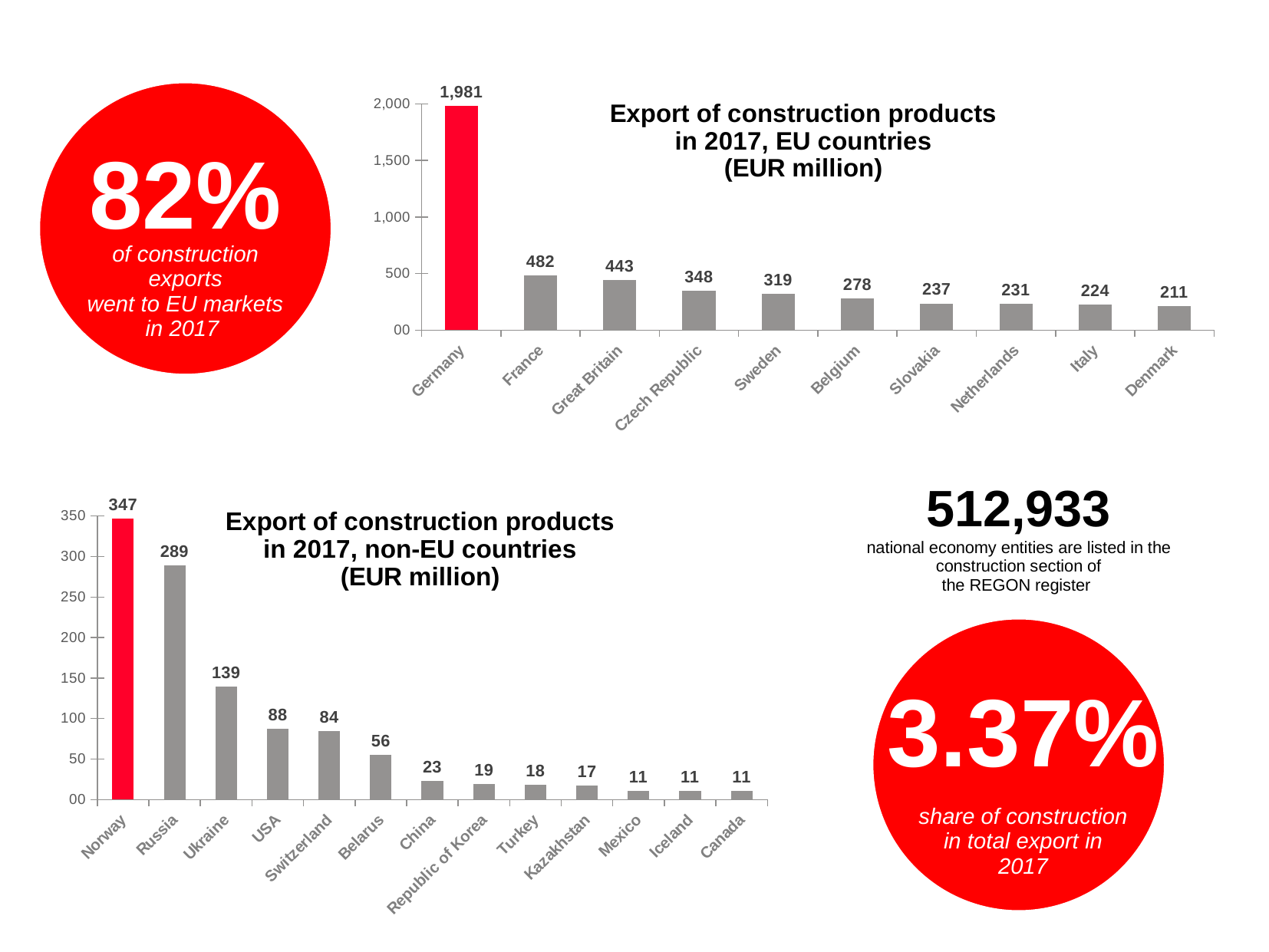
In the 'Export of construction products in 2017, non-EU countries' chart, how many countries are shown? 13 In the 'Export of construction products in 2017, non-EU countries' chart, what is the value for Russia? 289 In the 'Export of construction products in 2017, EU countries' chart, what is the value for Germany? 1,981 In the 'Export of construction products in 2017, EU countries' chart, which is larger, Sweden or Belgium? Sweden In the 'Export of construction products in 2017, EU countries' chart, how many countries are shown? 10 In the 'Export of construction products in 2017, EU countries' chart, which bar is coloured red? Germany In the 'Export of construction products in 2017, EU countries' chart, what is the difference between France and Great Britain? 39 In the 'Export of construction products in 2017, non-EU countries' chart, which country has the highest value? Norway In the 'Export of construction products in 2017, non-EU countries' chart, what is the difference between Norway and Russia? 58 In the 'Export of construction products in 2017, non-EU countries' chart, what is the value for Belarus? 56 In the 'Export of construction products in 2017, EU countries' chart, which country has the lowest value? Denmark What type of chart is the 'Export of construction products in 2017, non-EU countries' chart? Bar chart